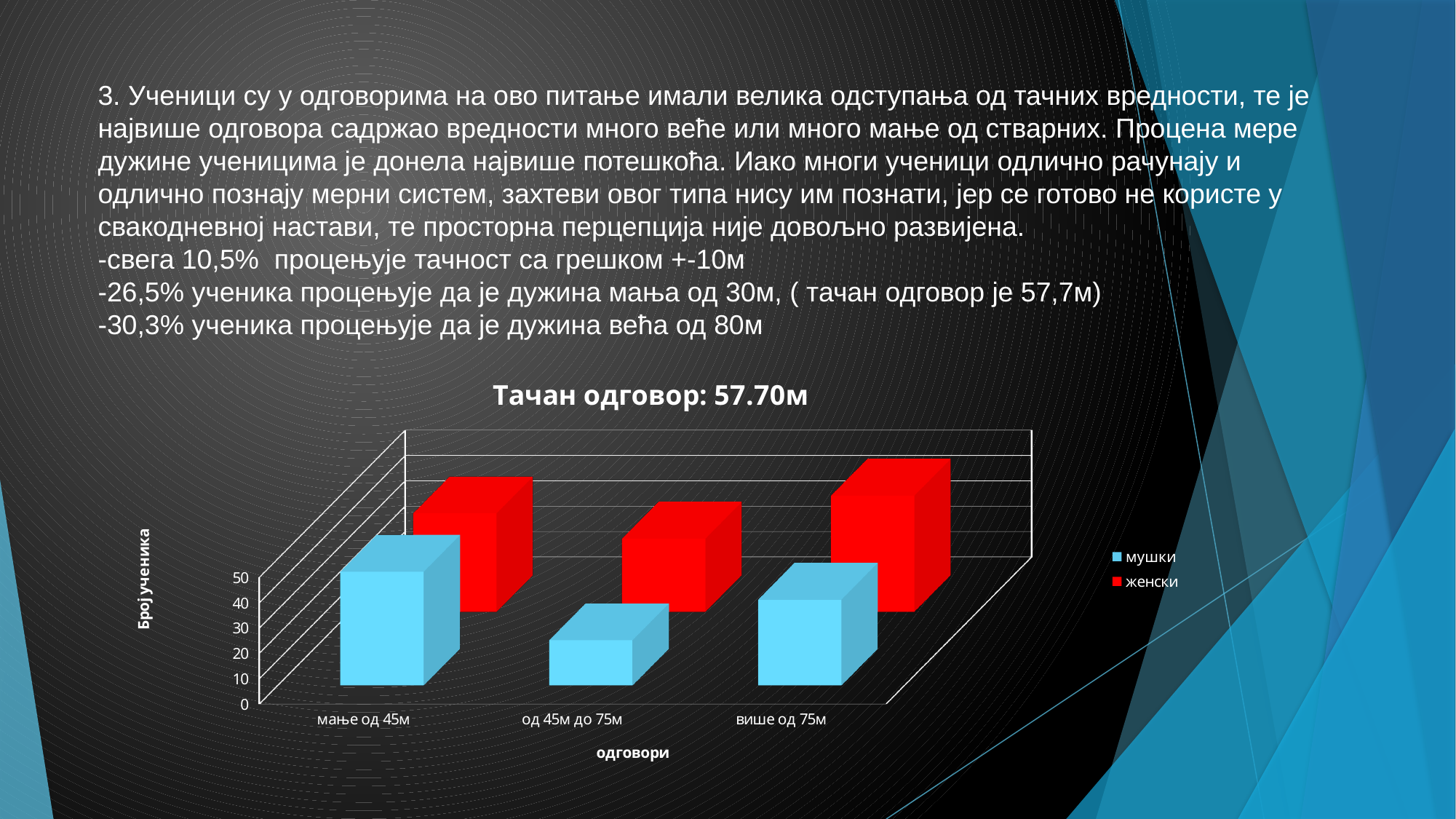
Which two series are listed in the chart legend? мушки and женски Which category has the lowest value for the женски series? од 45м до 75м Which category has the lowest value for the мушки series? од 45м до 75м Which category has the highest value for the мушки series? мање од 45м Is the мушки value for од 45м до 75м greater or less than 30? less How many series does the chart legend list? 2 Is the мушки value for мање од 45м greater or less than 30? greater What is the title of the chart? Тачан одговор: 57.70м What kind of chart is shown on the slide? bar chart Which category has the highest value for the женски series? више од 75м For the category од 45м до 75м, which series has the larger value, мушки or женски? женски How many categories are shown on the x axis of the chart? 3